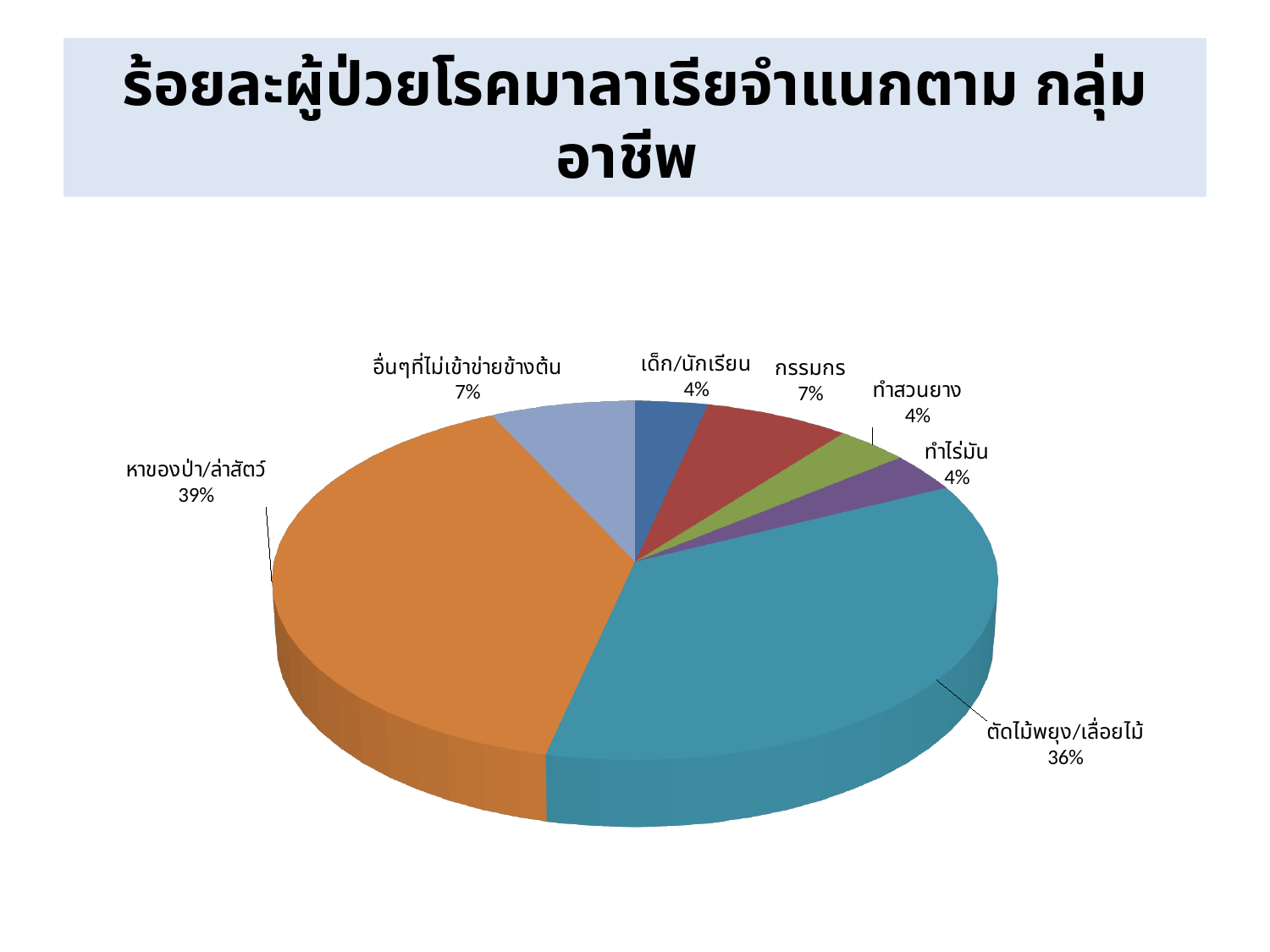
What percentage is shown for เด็ก/นักเรียน? 4% Which occupation group has the largest share of the pie? หาของป่า/ล่าสัตว์ What is the title of the chart? ร้อยละผู้ป่วยโรคมาลาเรียจำแนกตาม กลุ่มอาชีพ What kind of chart is shown on the slide? pie chart How many slices does the pie chart have? 7 What percentage is shown for อื่นๆที่ไม่เข้าข่ายข้างต้น? 7% What percentage is shown for ตัดไม้พยุง/เลื่อยไม้? 36% What percentage of malaria patients are in the หาของป่า/ล่าสัตว์ group? 39% How many occupation groups have a share of 4%? 3 Which has a larger share, กรรมกร or ทำสวนยาง? กรรมกร What is the difference in percentage points between หาของป่า/ล่าสัตว์ and ตัดไม้พยุง/เลื่อยไม้? 3% What share of the pie does กรรมกร represent? 7%